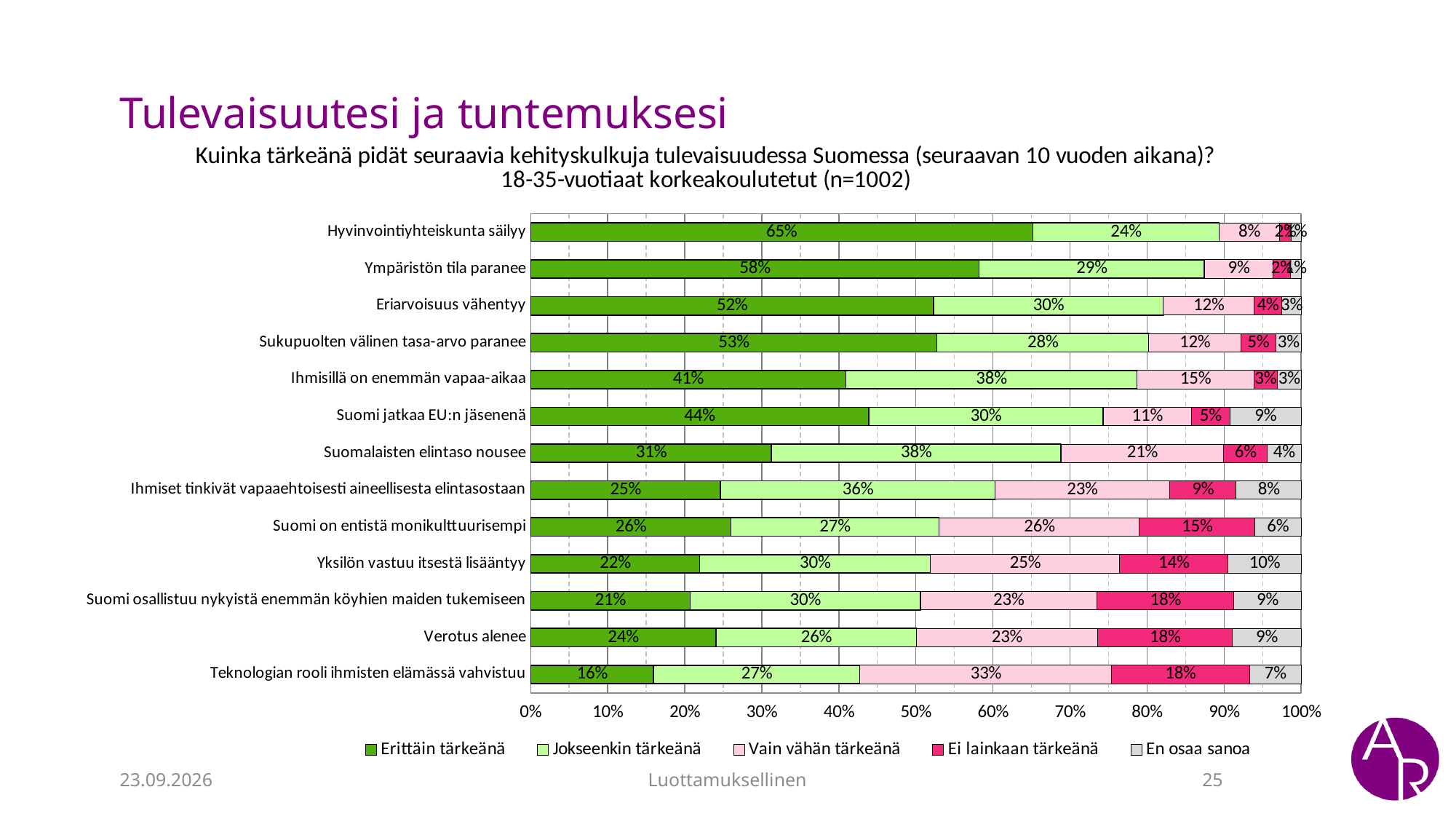
Which category has the lowest Erittäin tärkeänä share? Teknologian rooli ihmisten elämässä vahvistuu What is the Ei lainkaan tärkeänä value for 'Suomi on entistä monikulttuurisempi'? 15% Which has a larger Vain vähän tärkeänä value: 'Teknologian rooli ihmisten elämässä vahvistuu' or 'Verotus alenee'? Teknologian rooli ihmisten elämässä vahvistuu Which category has the highest Erittäin tärkeänä share? Hyvinvointiyhteiskunta säilyy How many categories are shown on the chart? 13 What is the En osaa sanoa value for 'Yksilön vastuu itsestä lisääntyy'? 10% Which legend entry is shown in dark green? Erittäin tärkeänä What kind of chart is shown on the slide? Stacked bar chart What is the Jokseenkin tärkeänä value for 'Ihmisillä on enemmän vapaa-aikaa'? 38% How many series does the legend list? 5 What percentage of respondents consider 'Hyvinvointiyhteiskunta säilyy' Erittäin tärkeänä? 65% What is the difference between the Erittäin tärkeänä values for 'Ympäristön tila paranee' and 'Eriarvoisuus vähentyy'? 6%